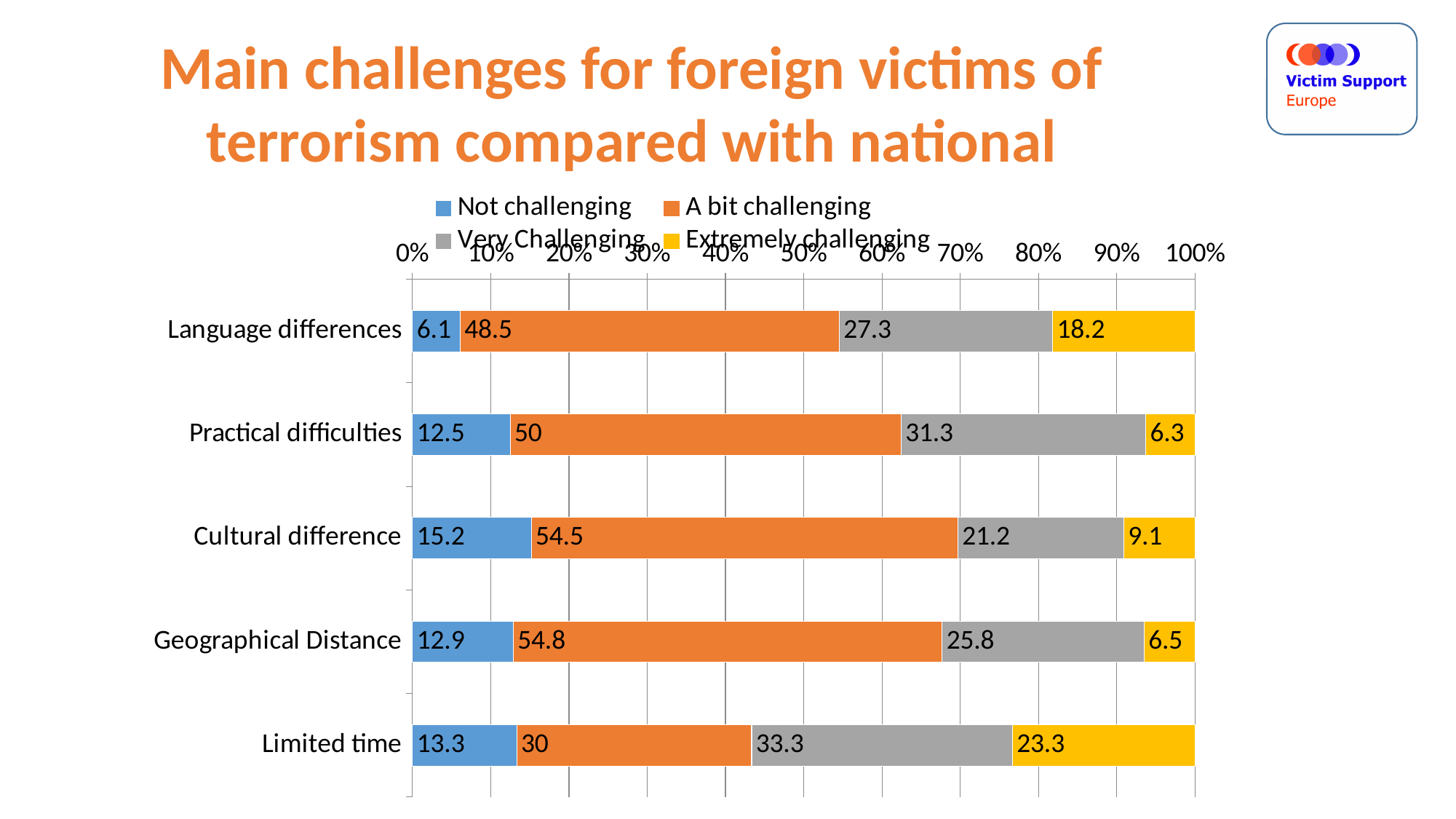
What is the value for "Not challenging" in the Language differences bar? 6.1 What is the value for "Extremely challenging" in the Limited time bar? 23.3 How many categories are shown on the chart? 5 What is the total of the four segments in the Cultural difference bar? 100 What is the value for "Very Challenging" in the Practical difficulties bar? 31.3 Which category has the lowest "Not challenging" value? Language differences What kind of chart is shown on the slide? Stacked bar chart Which is larger: the "Extremely challenging" value for Language differences or for Cultural difference? Language differences What colour represents "Extremely challenging" in the legend? Yellow Which category has the highest "Extremely challenging" value? Limited time How many series does the legend list? 4 For Language differences, what is the difference between the "A bit challenging" and "Very Challenging" values? 21.2